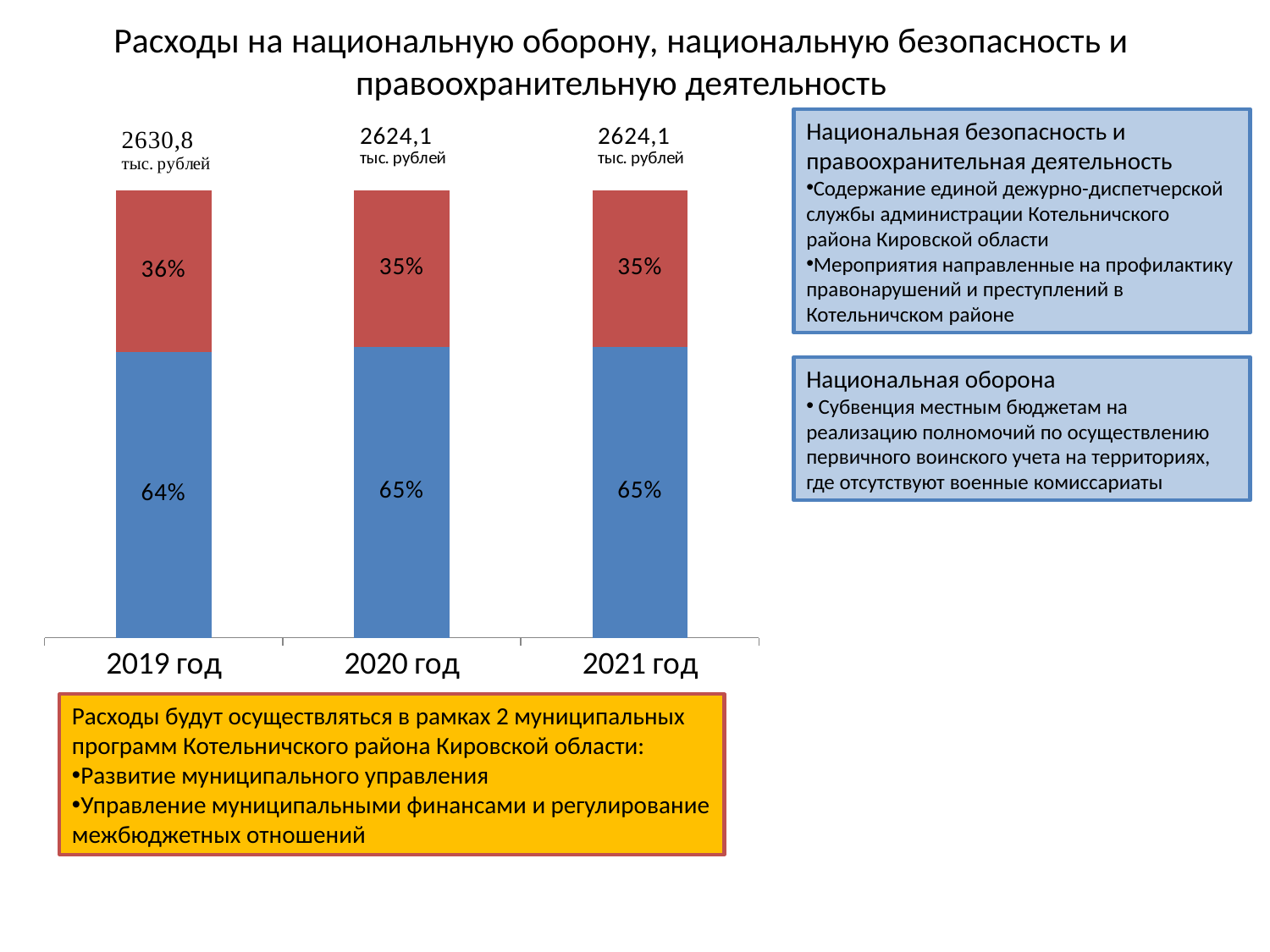
What percentage is labelled on the blue segment of the 2019 год bar? 64% What total amount is printed above the 2019 год bar? 2630,8 тыс. рублей What is the difference between the total amounts printed above the 2019 год and 2020 год bars? 6,7 тыс. рублей What is the title of the slide containing the chart? Расходы на национальную оборону, национальную безопасность и правоохранительную деятельность What kind of chart is shown on the slide? Stacked bar chart How many years (categories) are shown on the x axis of the chart? 3 What total amount is printed above the 2021 год bar? 2624,1 тыс. рублей By how many percentage points does the blue segment exceed the red segment in the 2019 год bar? 28 percentage points Which year has the highest total amount printed above its bar? 2019 год Does the share of the red segment rise or fall from 2019 год to 2020 год? Falls Which year has the larger blue segment share, 2019 год or 2020 год? 2020 год What percentage is labelled on the red segment of the 2020 год bar? 35%